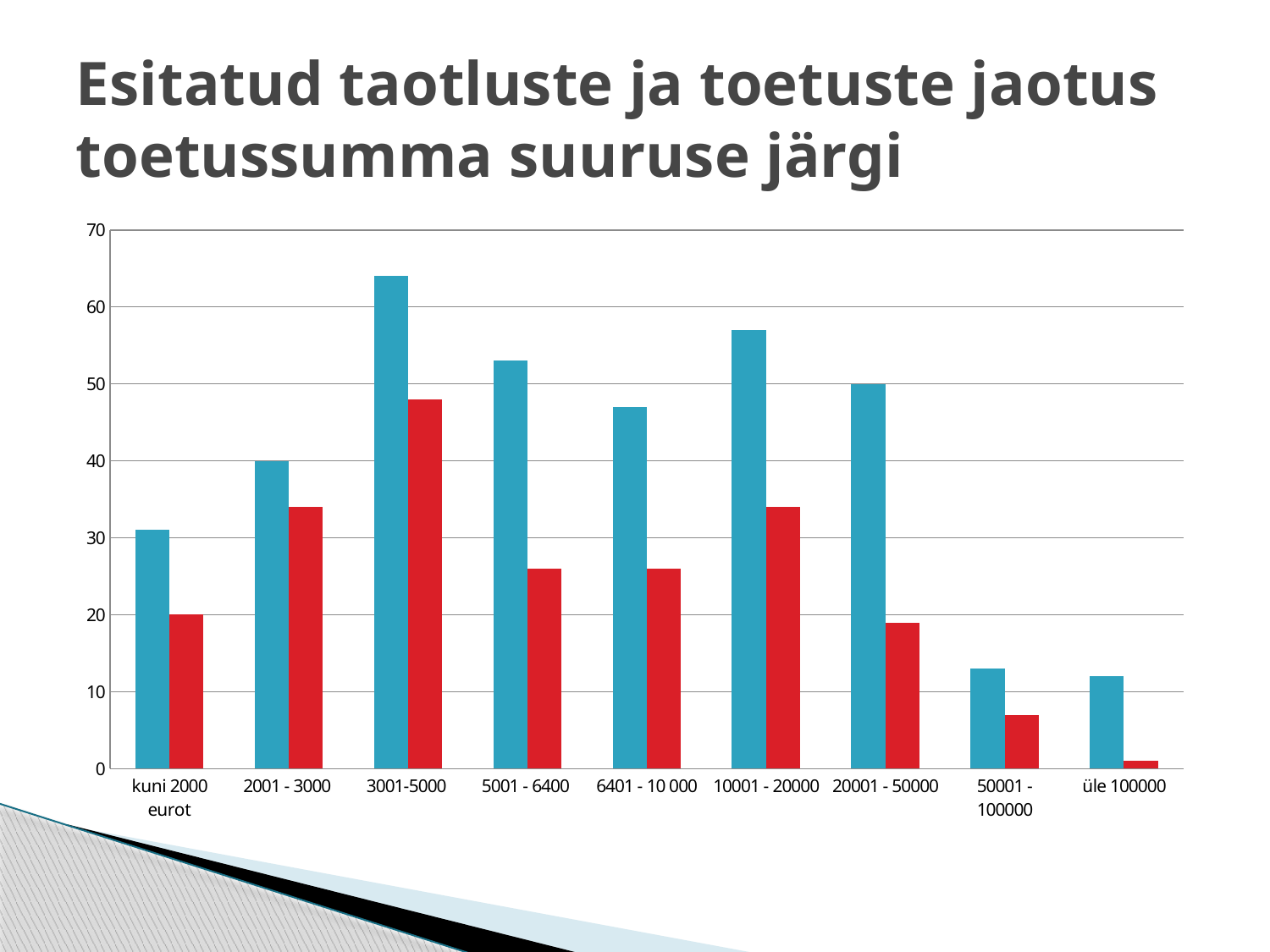
Which category has the tallest blue bar? 3001-5000 How many categories are shown on the x axis? 9 Which category has the shortest red bar? üle 100000 What is the title of the slide? Esitatud taotluste ja toetuste jaotus toetussumma suuruse järgi Which category has the shortest blue bar? üle 100000 Which category has the tallest red bar? 3001-5000 Which is larger for the category 5001 - 6400, the blue bar or the red bar? the blue bar How many bars are shown for each category? 2 What kind of chart is shown on the slide? bar chart Is the blue bar for 3001-5000 greater or less than 60? greater Is the blue bar for 10001 - 20000 greater or less than 50? greater